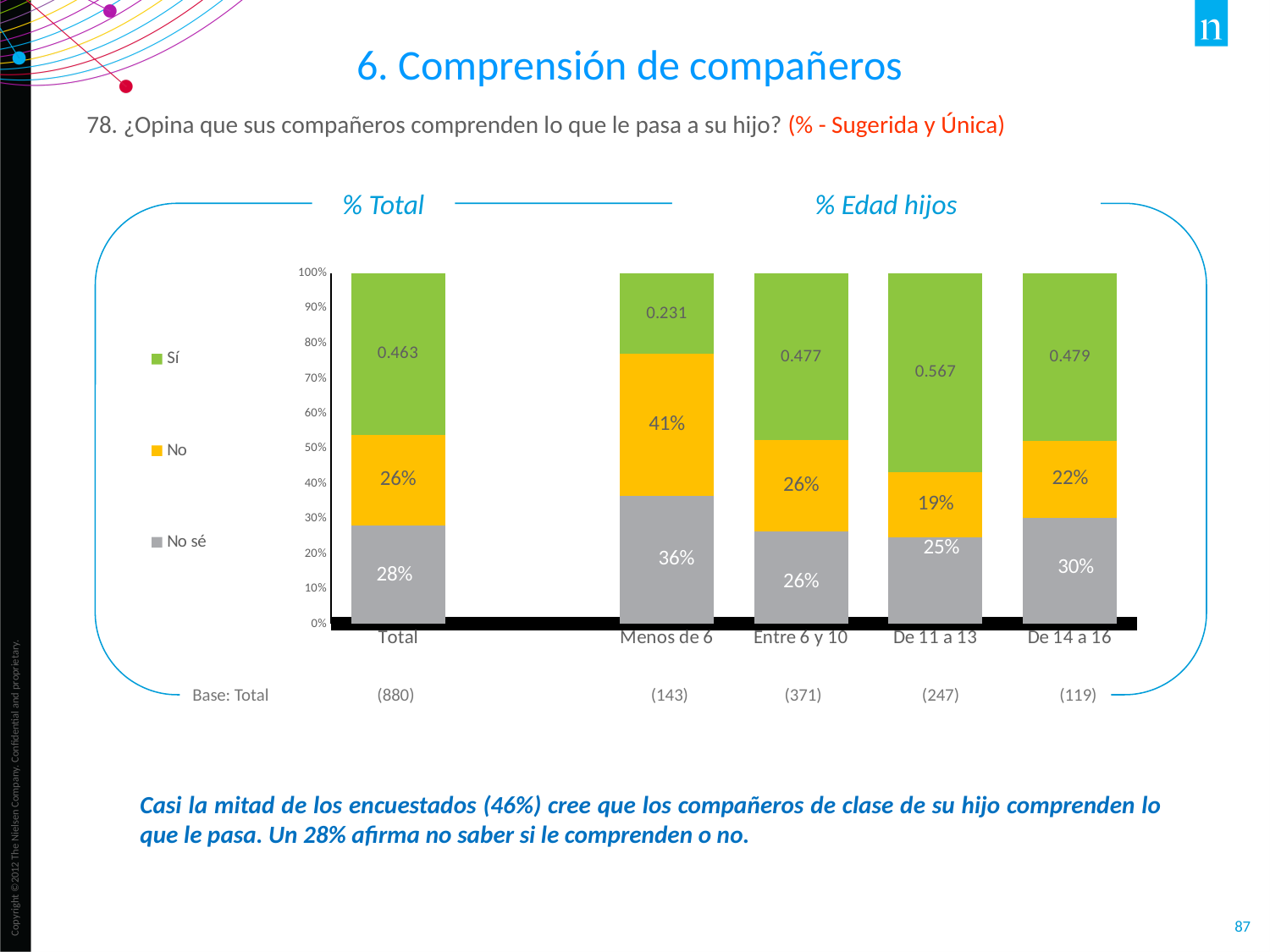
What is the value of 'No sé' for the 'Total' category? 28% What type of chart is shown on the slide? stacked bar chart What is the value of 'No sé' for the 'De 14 a 16' category? 30% Which category has the highest value for 'No'? Menos de 6 How many categories are shown on the x axis? 5 Which category has the lowest value for 'Sí'? Menos de 6 Which legend entry is shown in green? Sí What is the difference between the 'No' values for 'Menos de 6' and 'De 11 a 13'? 22% What is the value of 'Sí' for the 'De 11 a 13' category? 0.567 What is the value of 'No' for the 'Menos de 6' category? 41% Which is larger, the 'No sé' value for 'Menos de 6' or for 'Entre 6 y 10'? Menos de 6 How many series does the legend list? 3